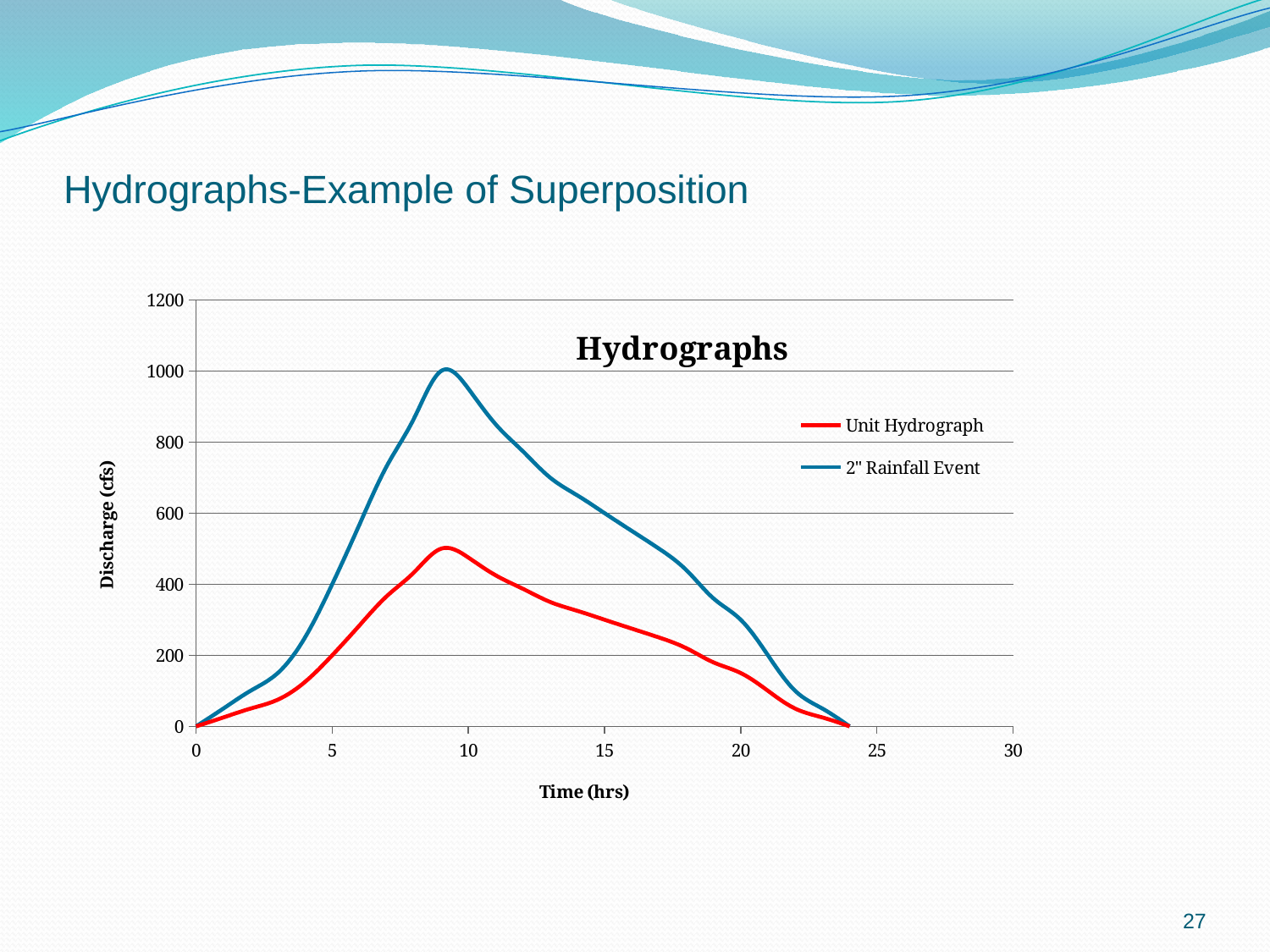
Which series reaches the higher peak discharge? 2" Rainfall Event How many series does the legend list? 2 Is the peak value of the Unit Hydrograph series greater or less than 600? less Is the value of the 2" Rainfall Event series at 15 hrs greater or less than 400? greater Is the peak value of the 2" Rainfall Event series greater or less than 800? greater What kind of chart is shown on the slide? line chart What is the label on the vertical axis of the chart? Discharge (cfs) At 10 hrs, which series has the larger discharge value? 2" Rainfall Event What are the two series named in the legend? Unit Hydrograph and 2" Rainfall Event